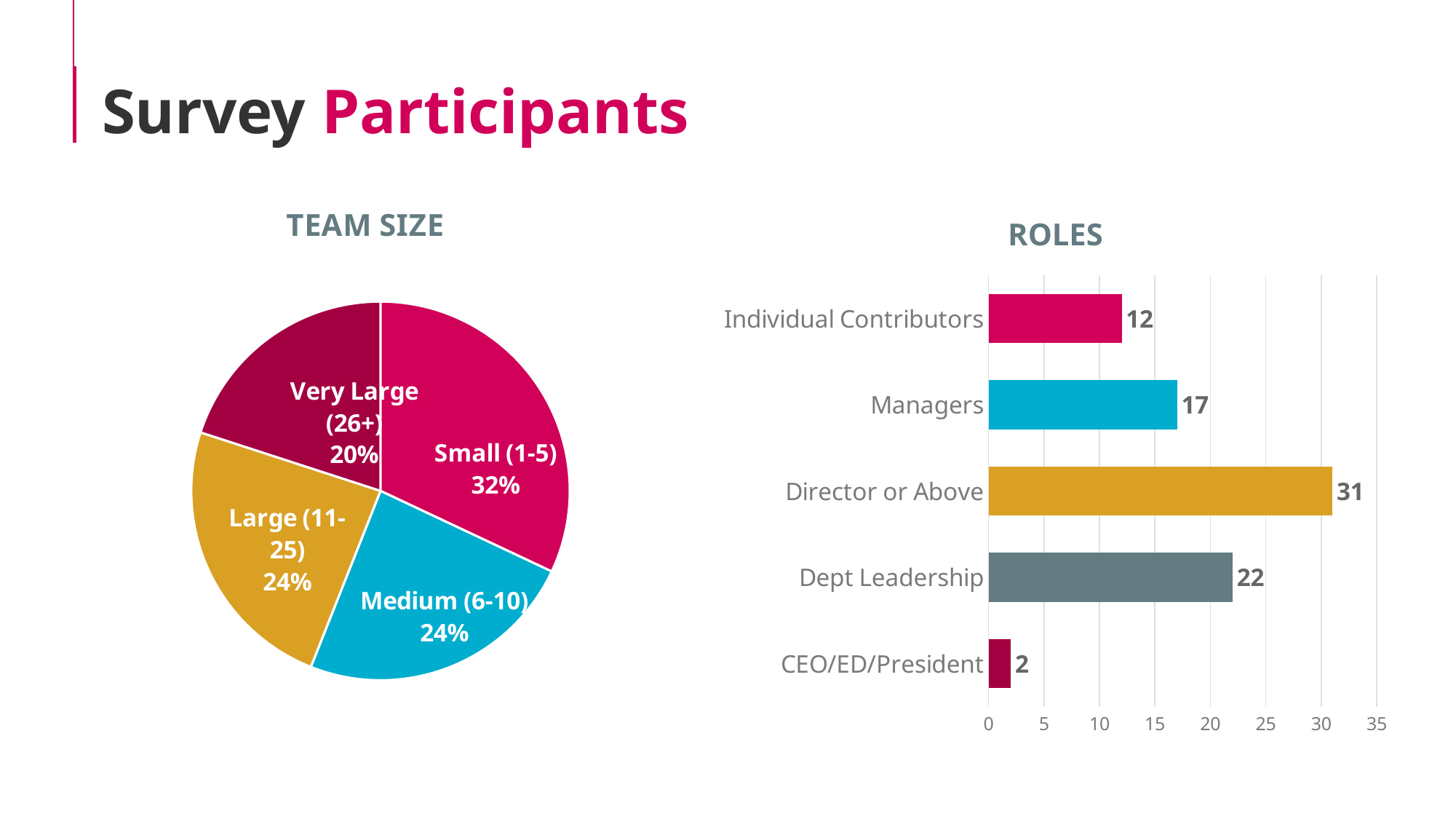
In the TEAM SIZE chart, what share of participants have a Small (1-5) team? 32% In the TEAM SIZE chart, which team size has the smallest share? Very Large (26+) In the ROLES chart, what is the difference between Director or Above and Dept Leadership? 9 In the ROLES chart, which role has the lowest value? CEO/ED/President In the TEAM SIZE chart, what share of participants have a Very Large (26+) team? 20% What kind of chart is the ROLES chart? Bar chart In the TEAM SIZE chart, how many slices does the pie have? 4 What kind of chart is the TEAM SIZE chart? Pie chart In the TEAM SIZE chart, which team size has the largest share? Small (1-5) In the ROLES chart, what is the value for Director or Above? 31 In the ROLES chart, which is larger, Individual Contributors or Managers? Managers In the ROLES chart, what is the value for Managers? 17